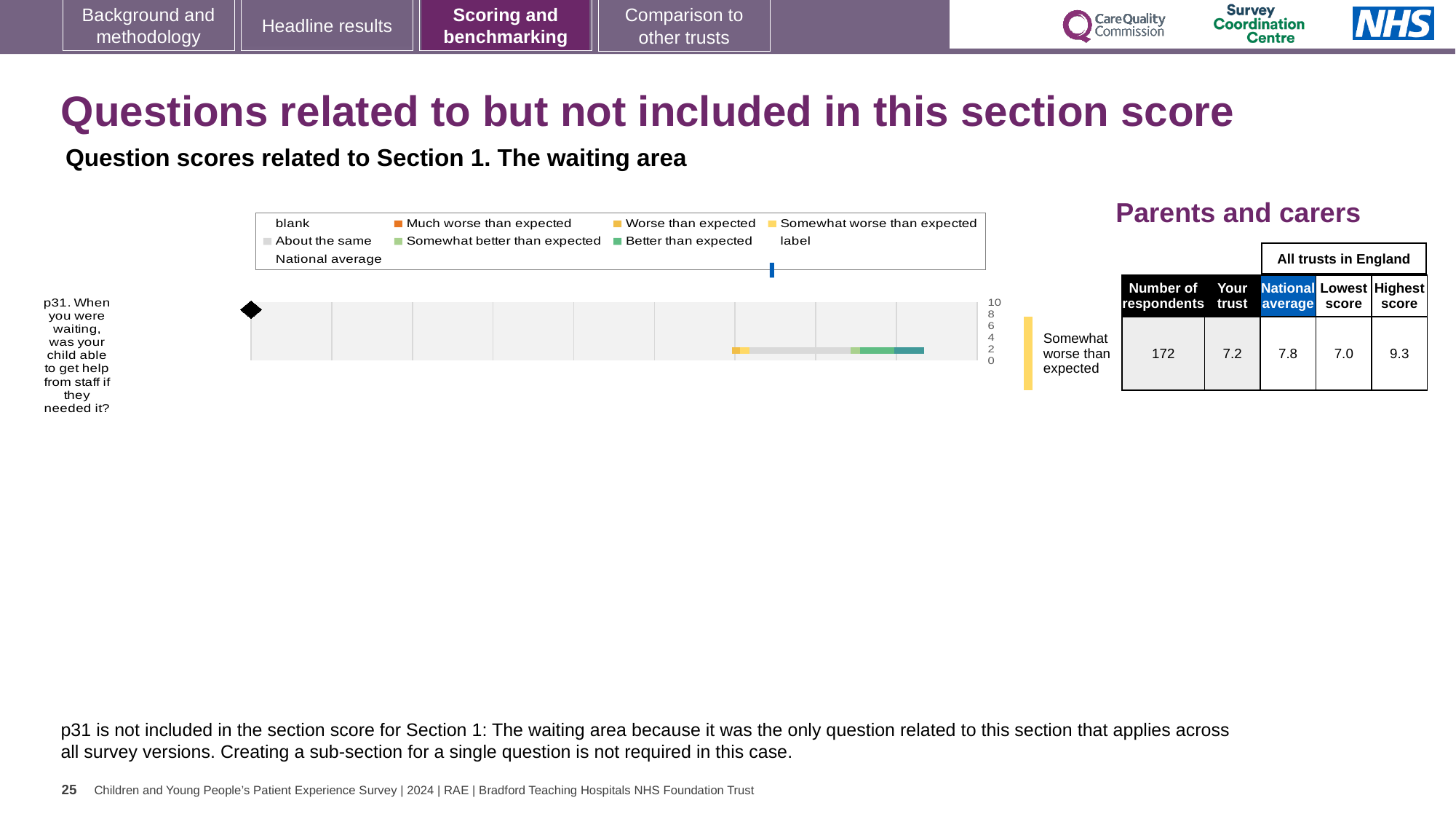
In the table beside the chart, what is the highest score among all trusts in England for p31? 9.3 In the table beside the chart, how many respondents answered p31? 172 For p31, what is the difference between the highest score and the lowest score among all trusts in England? 2.3 For p31, which is larger: the 'Your trust' score or the national average? National average In the table beside the chart, what is the national average score for p31? 7.8 How many survey questions are plotted in the chart? 1 What kind of chart is used to show the p31 question score? bar chart For p31, what is the difference between the national average and the 'Your trust' score? 0.6 What benchmark category is shown next to the bar for question p31? Somewhat worse than expected In the table beside the chart, what is the lowest score among all trusts in England for p31? 7.0 Which legend entry is shown in orange in the chart legend? Much worse than expected In the table beside the chart, what is the 'Your trust' score for p31? 7.2